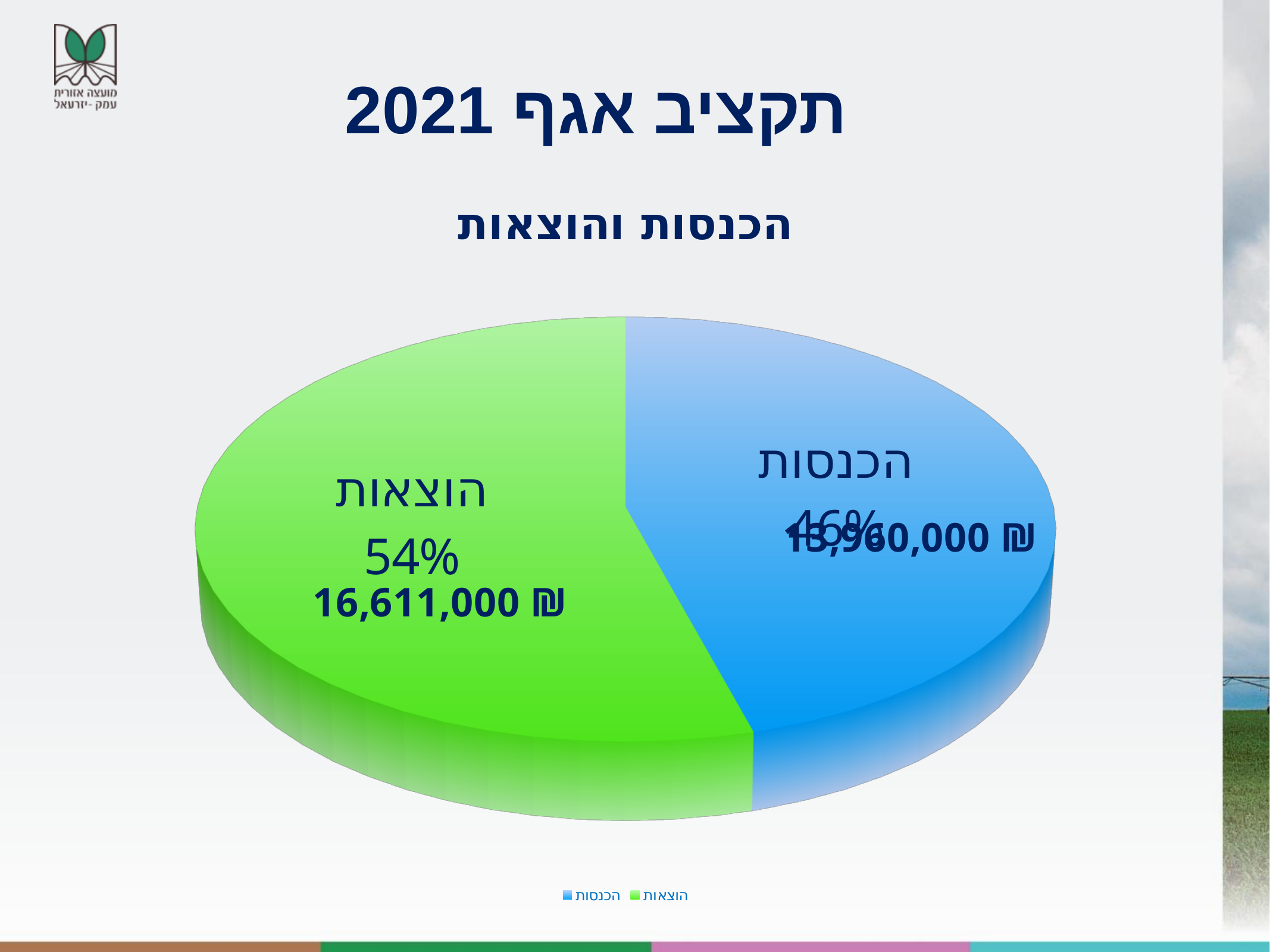
What share of the pie does the הוצאות slice represent? 54% Which slice of the pie chart is the smallest? הכנסות What kind of chart is shown on the slide? Pie chart Which is larger, the הוצאות slice or the הכנסות slice? הוצאות Is the share for הוצאות greater or less than 50%? greater Which slice of the pie chart is the largest? הוצאות What share of the pie does the הכנסות slice represent? 46% How many slices does the pie chart have? 2 What is the title of the chart? הכנסות והוצאות What value is labelled on the הוצאות slice? 16,611,000 ₪ What colour is the הוצאות slice? Green How many entries does the legend list? 2